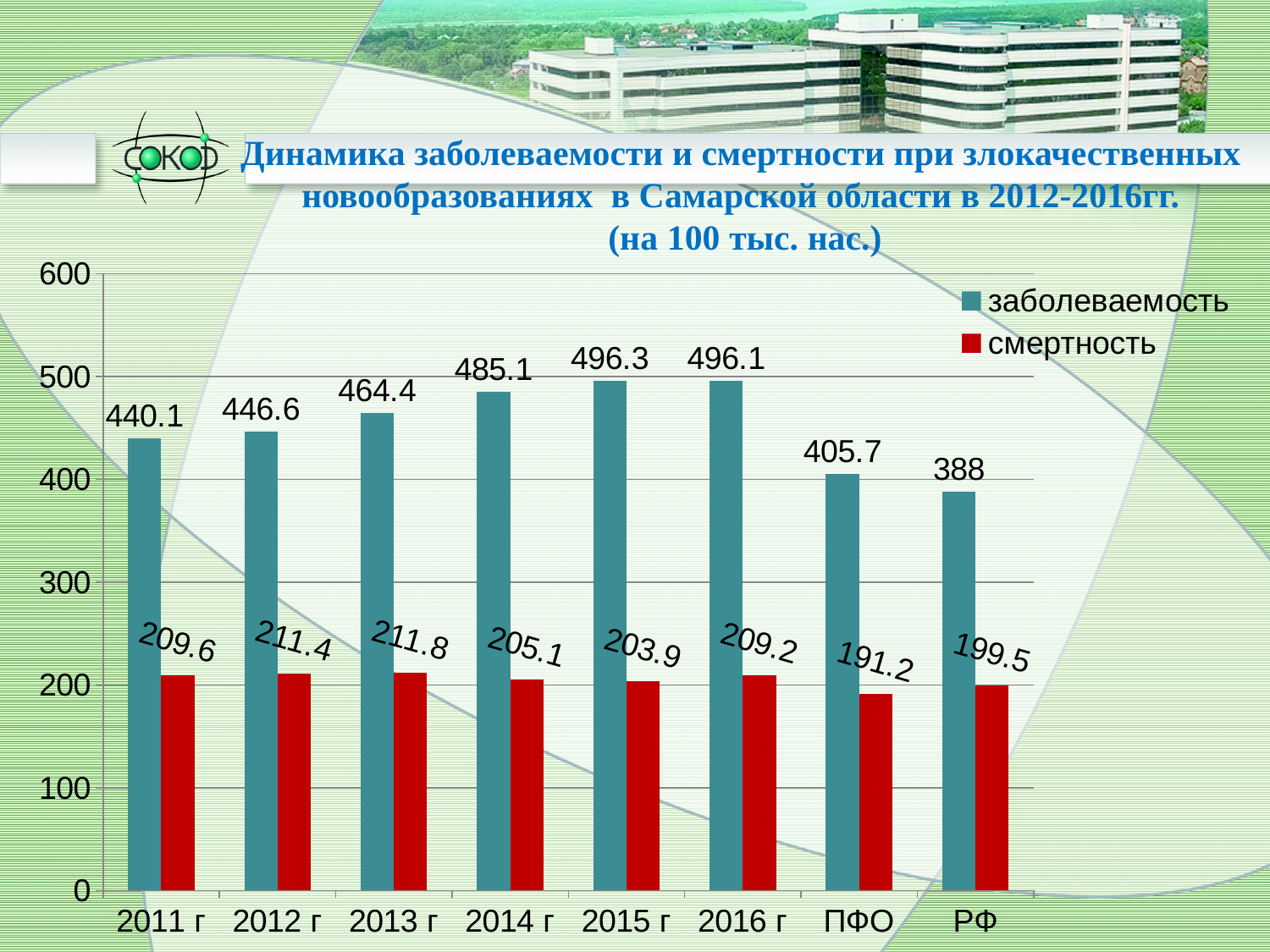
What is the смертность value for ПФО? 191.2 What is the заболеваемость value for 2014 г? 485.1 What is the difference between the заболеваемость values for 2016 г and 2011 г? 56 Which category has the lowest заболеваемость value? РФ Which is larger, the смертность value for 2012 г or for 2015 г? 2012 г Which category has the lowest смертность value? ПФО How many categories are shown on the x axis? 8 Does the заболеваемость value rise or fall from 2011 г to 2015 г? rise Which series is shown in red in the legend? смертность How many series does the legend list? 2 What type of chart is shown on the slide? bar chart What is the заболеваемость value for РФ? 388